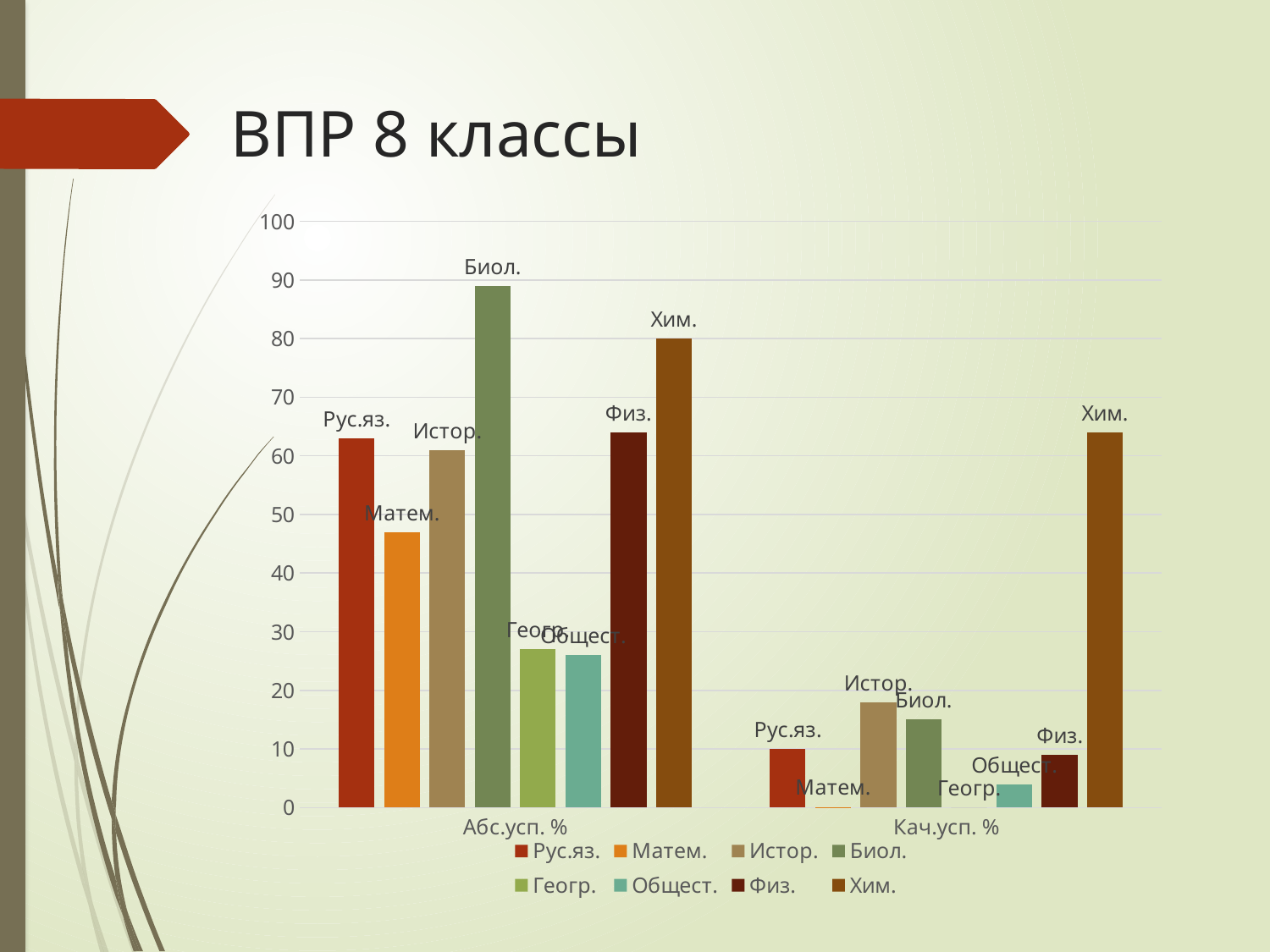
What kind of chart is shown on the slide? bar chart Is the value for Истор. in Кач.усп. % greater or less than 20? less Is the value for Биол. in Абс.усп. % greater or less than 80? greater Which subject has the highest bar in the Абс.усп. % category? Биол. Is the value for Матем. in Абс.усп. % greater or less than 50? less Which subject has the highest bar in the Кач.усп. % category? Хим. Which category on the x axis is listed first, on the left? Абс.усп. % How many series does the legend list? 8 Which is larger in Абс.усп. %: the value for Хим. or the value for Физ.? Хим. What is the title of the slide containing the chart? ВПР 8 классы Which is larger in Кач.усп. %: the value for Истор. or the value for Общест.? Истор. How many categories are shown on the x axis? 2